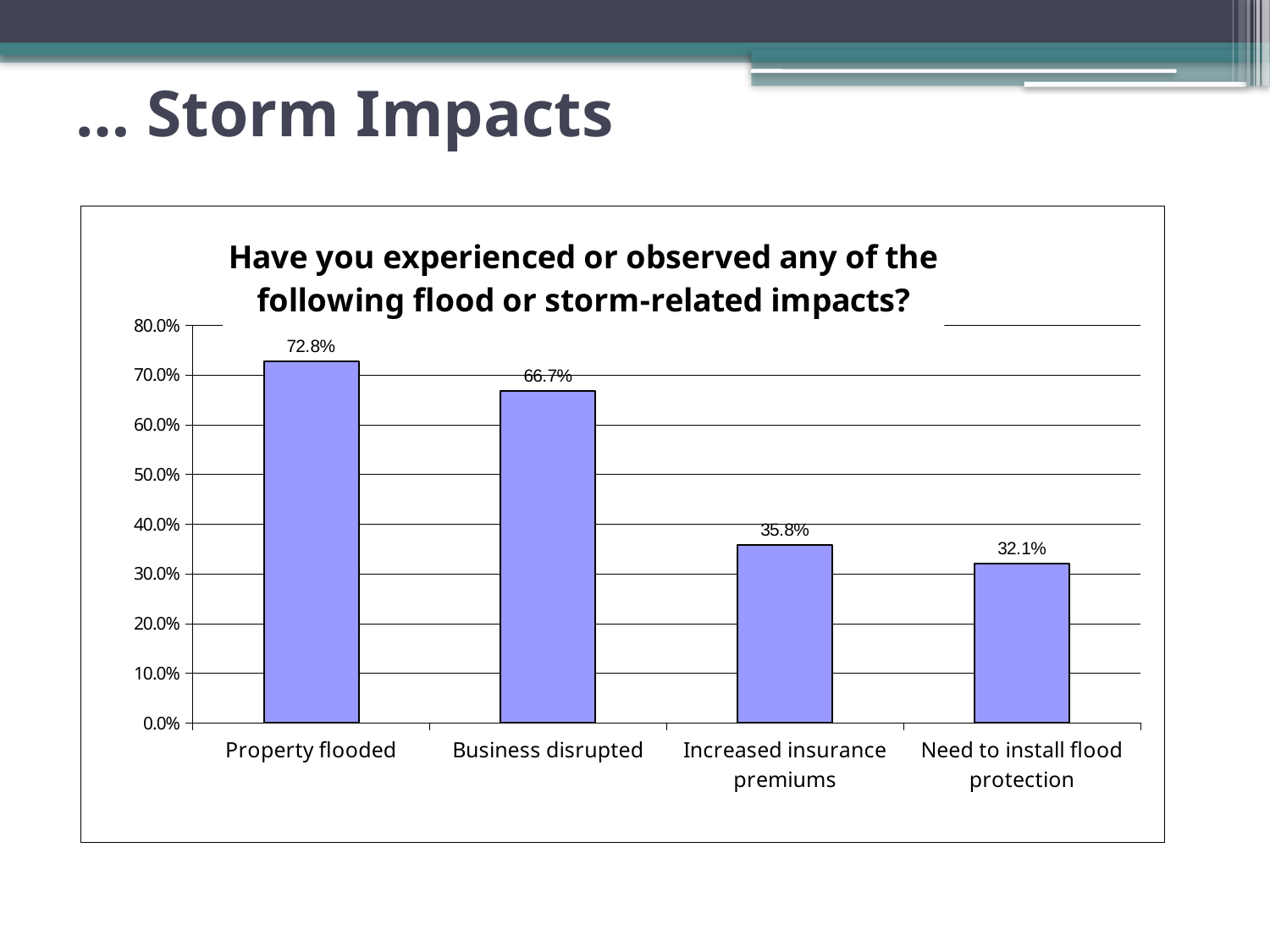
What is the value for Need to install flood protection? 32.1% What is the difference in percentage points between Property flooded and Business disrupted? 6.1 How many impact categories are shown on the chart? 4 What is the value shown for Business disrupted? 66.7% What percentage is shown for Increased insurance premiums? 35.8% What percentage of respondents reported that their property flooded? 72.8% Which impact has the highest percentage? Property flooded What is the difference in percentage points between Increased insurance premiums and Need to install flood protection? 3.7 Is the value for Increased insurance premiums greater or less than 40.0%? less Which impact has the lowest percentage? Need to install flood protection What type of chart is shown on the slide? Bar chart Which is larger: the value for Business disrupted or the value for Increased insurance premiums? Business disrupted